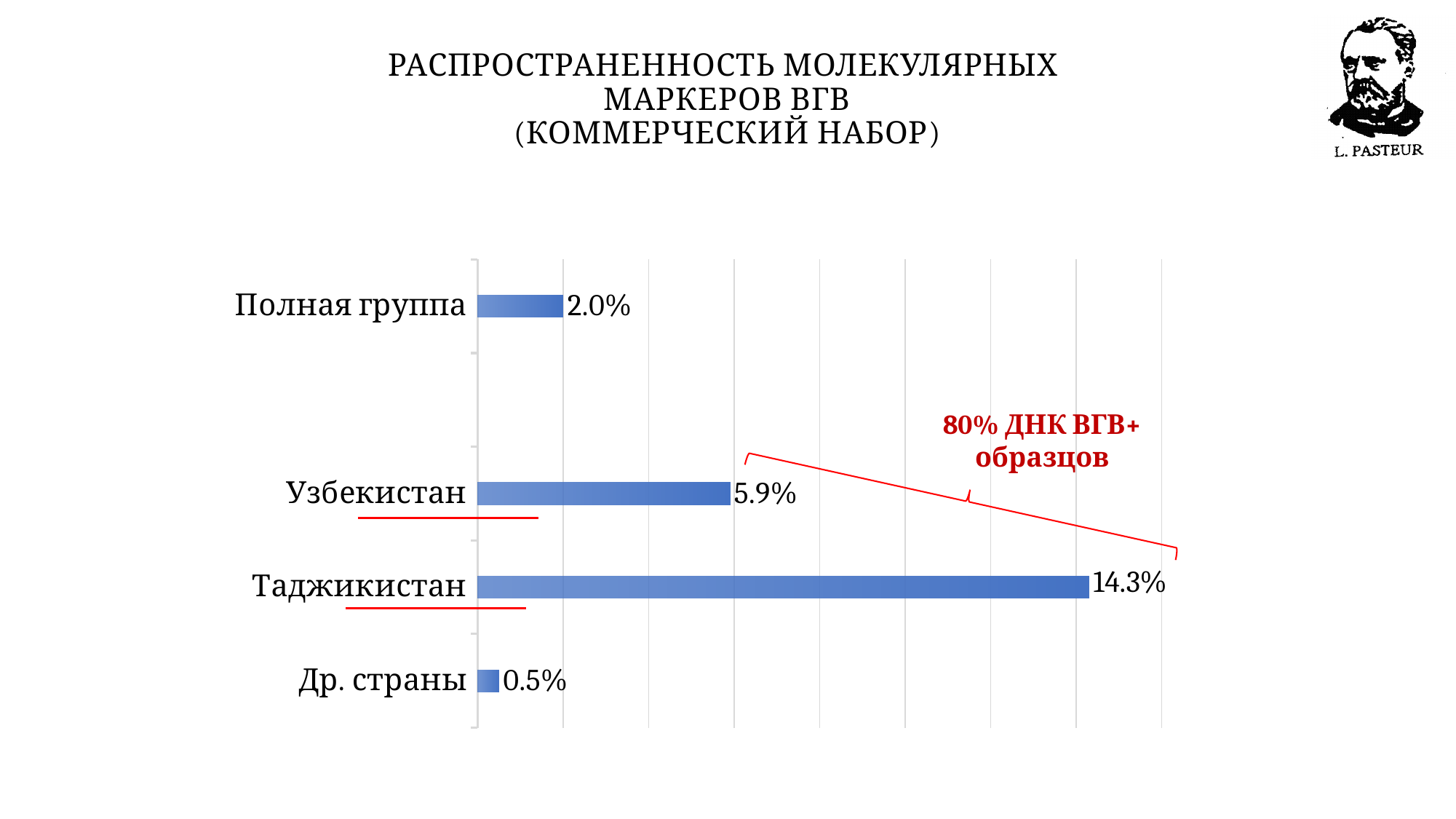
What kind of chart is shown on the slide? Bar chart Which is larger, the value for Узбекистан or the value for Полная группа? Узбекистан What is the value for Полная группа? 2.0% What is the difference between the values for Полная группа and Др. страны? 1.5% What is the value for Др. страны? 0.5% What is the value for Узбекистан? 5.9% Which category has the lowest value? Др. страны Which category has the highest value? Таджикистан What is the value for Таджикистан? 14.3% What does the red annotation on the chart say? 80% ДНК ВГВ+ образцов What is the difference between the values for Таджикистан and Узбекистан? 8.4% How many categories are shown in the chart? 4